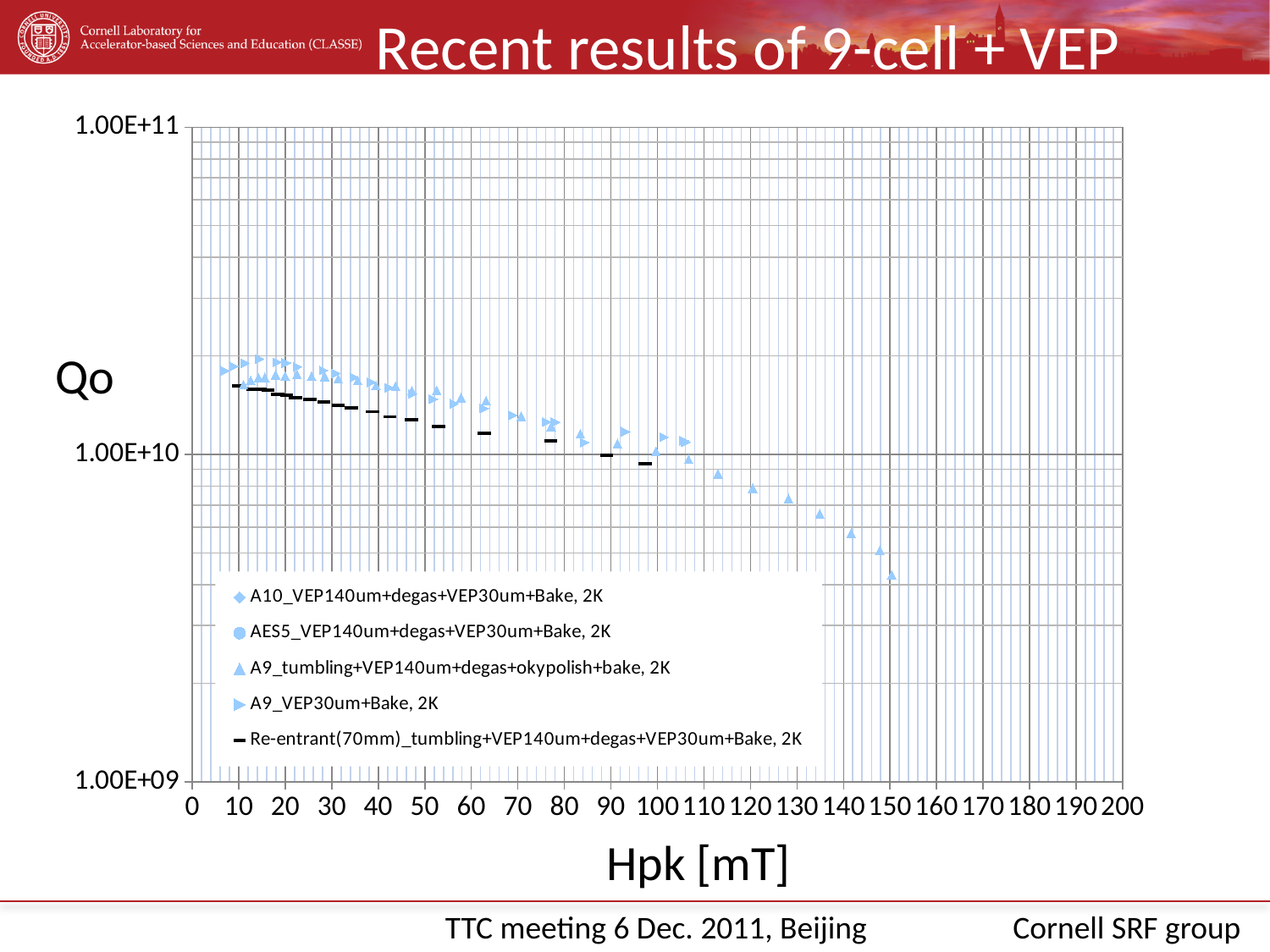
What is the label of the x axis? Hpk [mT] How many series does the legend list? 5 What kind of chart is shown on the slide? Scatter chart Is the Qo value for the A9_tumbling+VEP140um+degas+okypolish+bake, 2K series at Hpk 150 mT greater or less than 1.00E+09? greater Is the Qo value for the Re-entrant(70mm)_tumbling+VEP140um+degas+VEP30um+Bake, 2K series at Hpk 10 mT greater or less than 1.00E+10? greater Which series is listed last in the legend? Re-entrant(70mm)_tumbling+VEP140um+degas+VEP30um+Bake, 2K What is the maximum value shown on the x axis? 200 At Hpk 20 mT, which series has the lower Qo: the Re-entrant(70mm) series or the A9_tumbling series? Re-entrant(70mm)_tumbling+VEP140um+degas+VEP30um+Bake, 2K Do the Qo values rise or fall as Hpk increases? Fall Is the Qo value for the Re-entrant(70mm)_tumbling+VEP140um+degas+VEP30um+Bake, 2K series at Hpk 60 mT greater or less than 1.00E+10? greater Which series reaches the highest Hpk value on the chart? A9_tumbling+VEP140um+degas+okypolish+bake, 2K